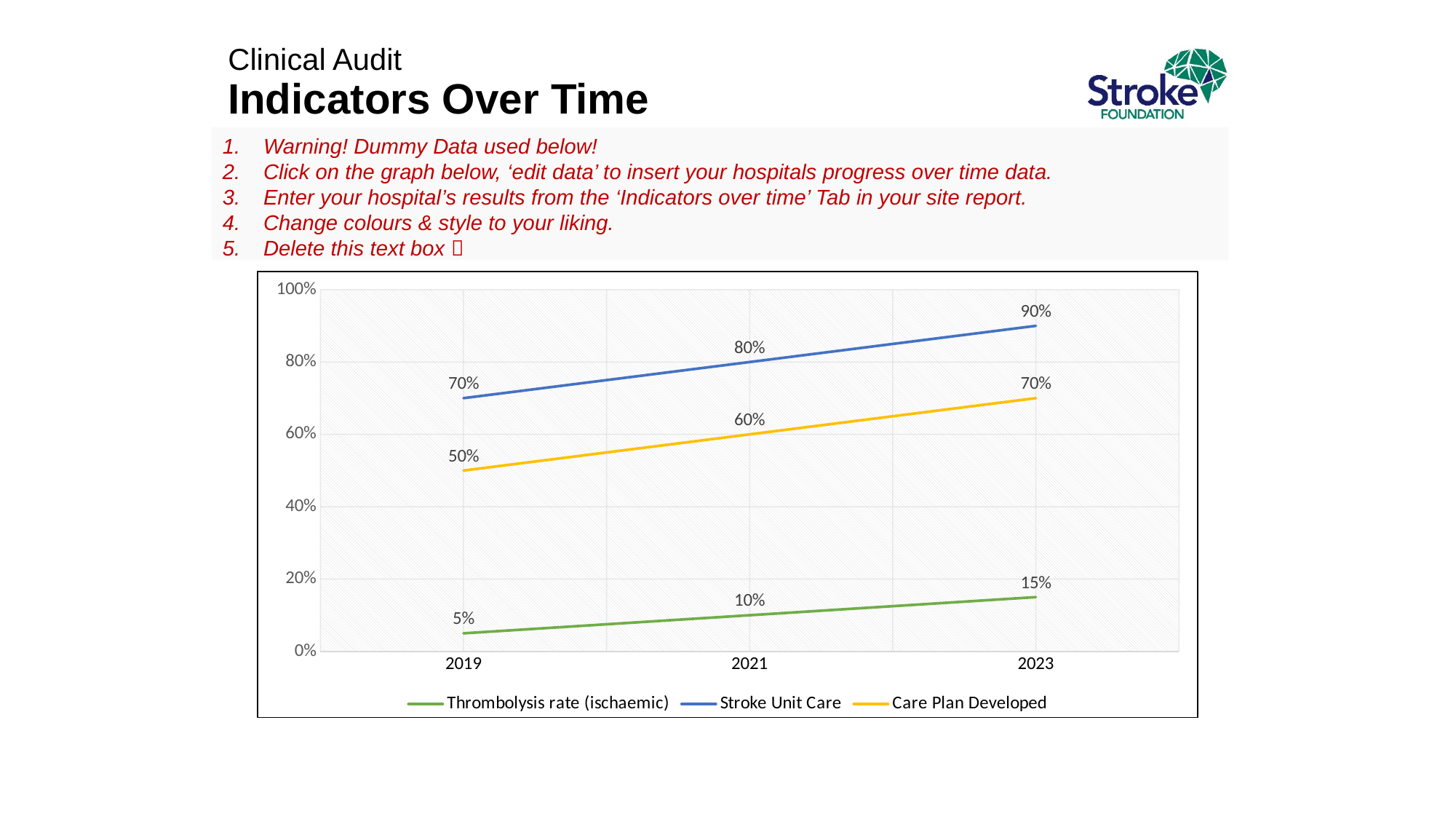
How many series does the legend list? 3 What is the Care Plan Developed value for 2023? 70% What kind of chart is shown on the slide? Line chart In which year is the Stroke Unit Care value highest? 2023 How many years are shown on the x axis? 3 What is the difference between the Stroke Unit Care value and the Care Plan Developed value in 2019? 20% Does the Care Plan Developed series rise or fall from 2019 to 2023? Rise By how much did the Thrombolysis rate (ischaemic) increase from 2019 to 2023? 10% In which year is the Care Plan Developed value lowest? 2019 What is the Thrombolysis rate (ischaemic) value for 2019? 5% Which is larger in 2021: Stroke Unit Care or Care Plan Developed? Stroke Unit Care What is the Stroke Unit Care value for 2021? 80%